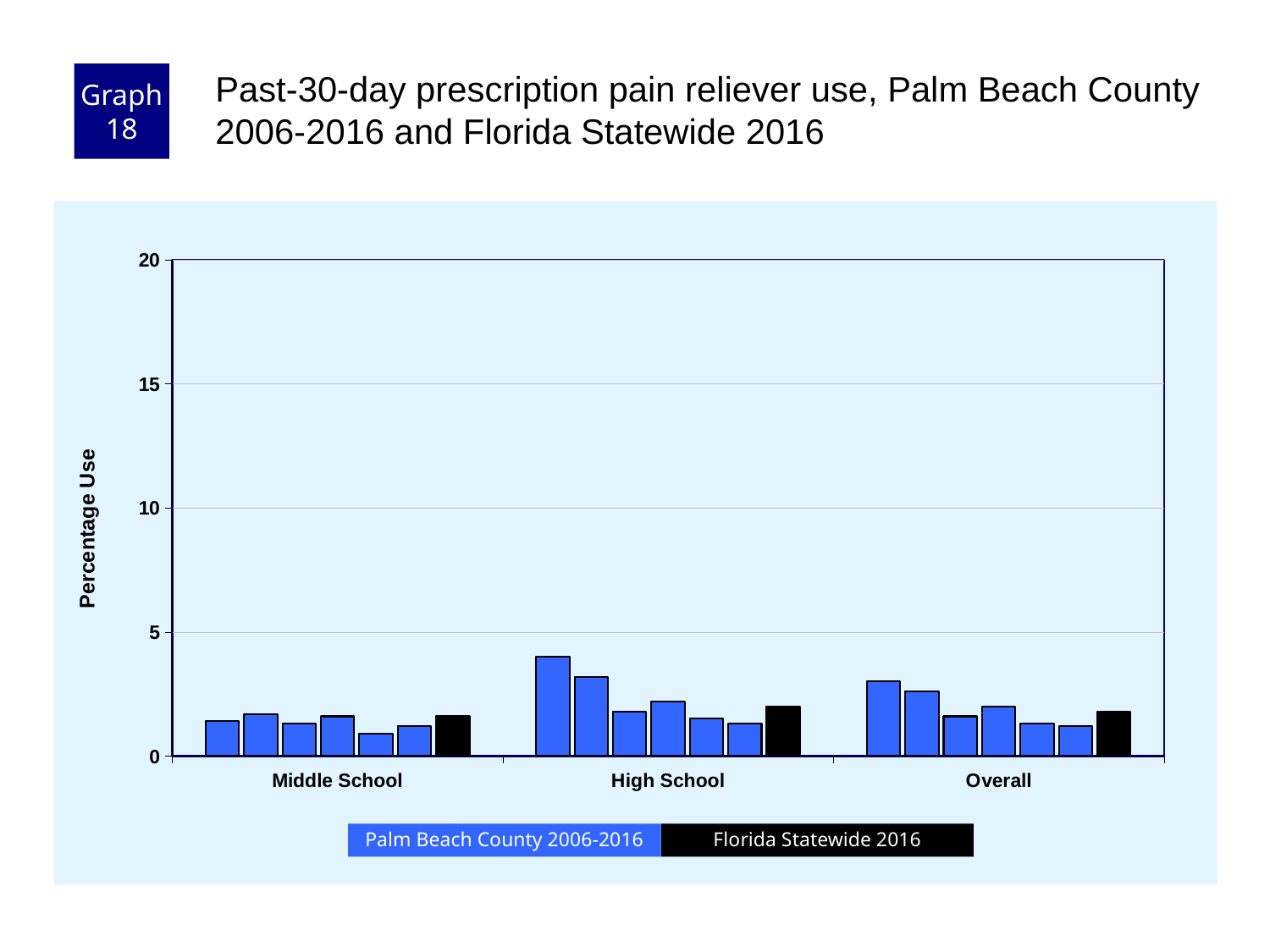
What is the label on the y axis? Percentage Use Which is larger: the Florida Statewide 2016 value for High School or for Middle School? High School Is the tallest Palm Beach County bar in the High School group greater or less than 5? less Is the Florida Statewide 2016 value for High School greater or less than 5? less What kind of chart is shown on the slide? bar chart How many bars are plotted in each category group? 7 How many series does the legend list? 2 Which series is shown in black in the legend? Florida Statewide 2016 Is the Florida Statewide 2016 value for Middle School greater or less than 5? less How many school-level categories are shown on the x axis? 3 Which category group contains the tallest bar on the chart? High School